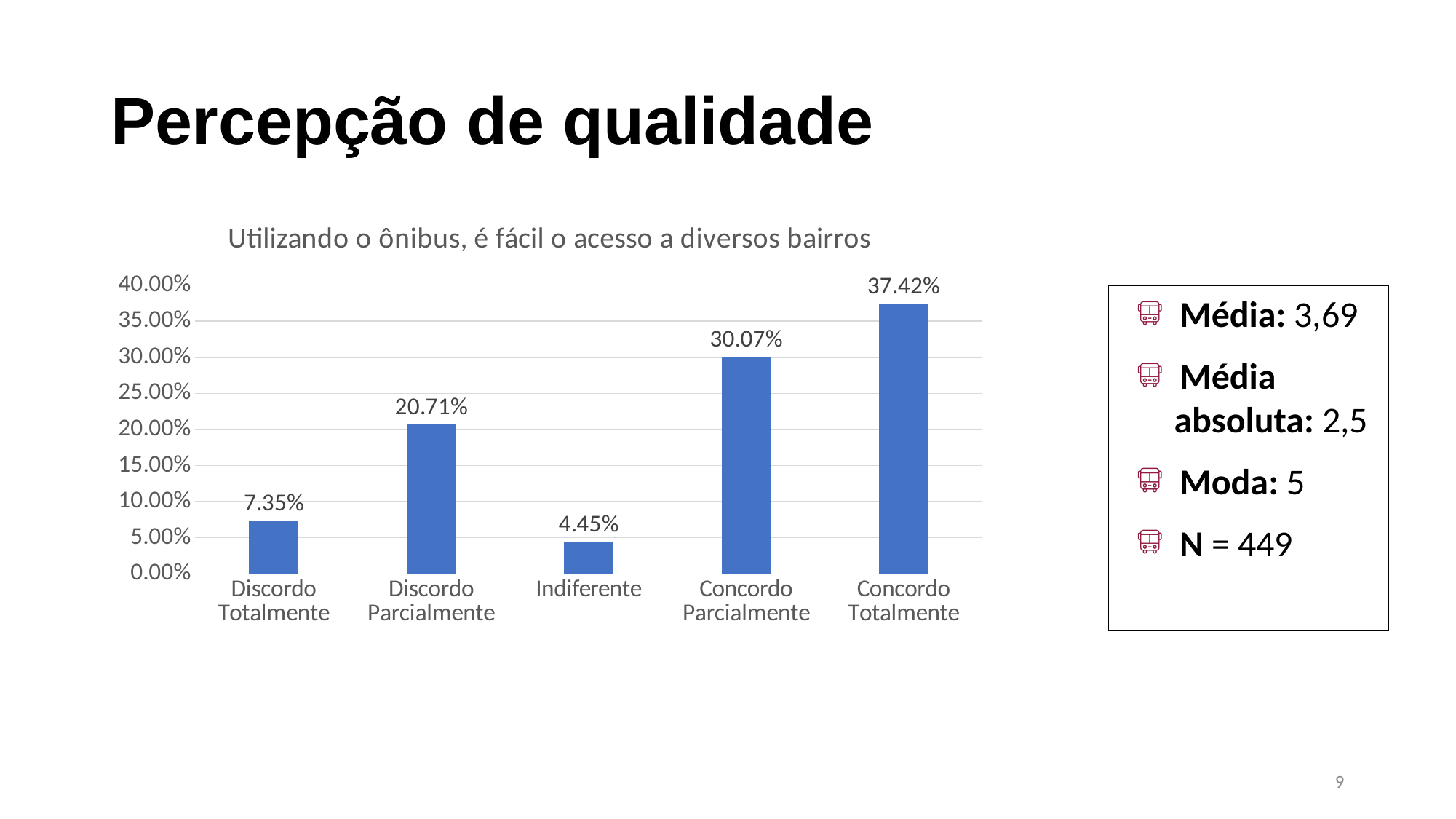
What is the value for Indiferente? 4.45% How many categories are shown on the x axis? 5 What is the title of the chart? Utilizando o ônibus, é fácil o acesso a diversos bairros Which is larger, Discordo Totalmente or Indiferente? Discordo Totalmente Which category has the lowest value? Indiferente What is the value for Concordo Totalmente? 37.42% What is the difference between Discordo Parcialmente and Discordo Totalmente? 13.36% What is the difference between Concordo Totalmente and Concordo Parcialmente? 7.35% What kind of chart is shown? bar chart What is the value for Discordo Parcialmente? 20.71% Is the value for Concordo Parcialmente greater or less than 25.00%? greater Which category has the highest value? Concordo Totalmente